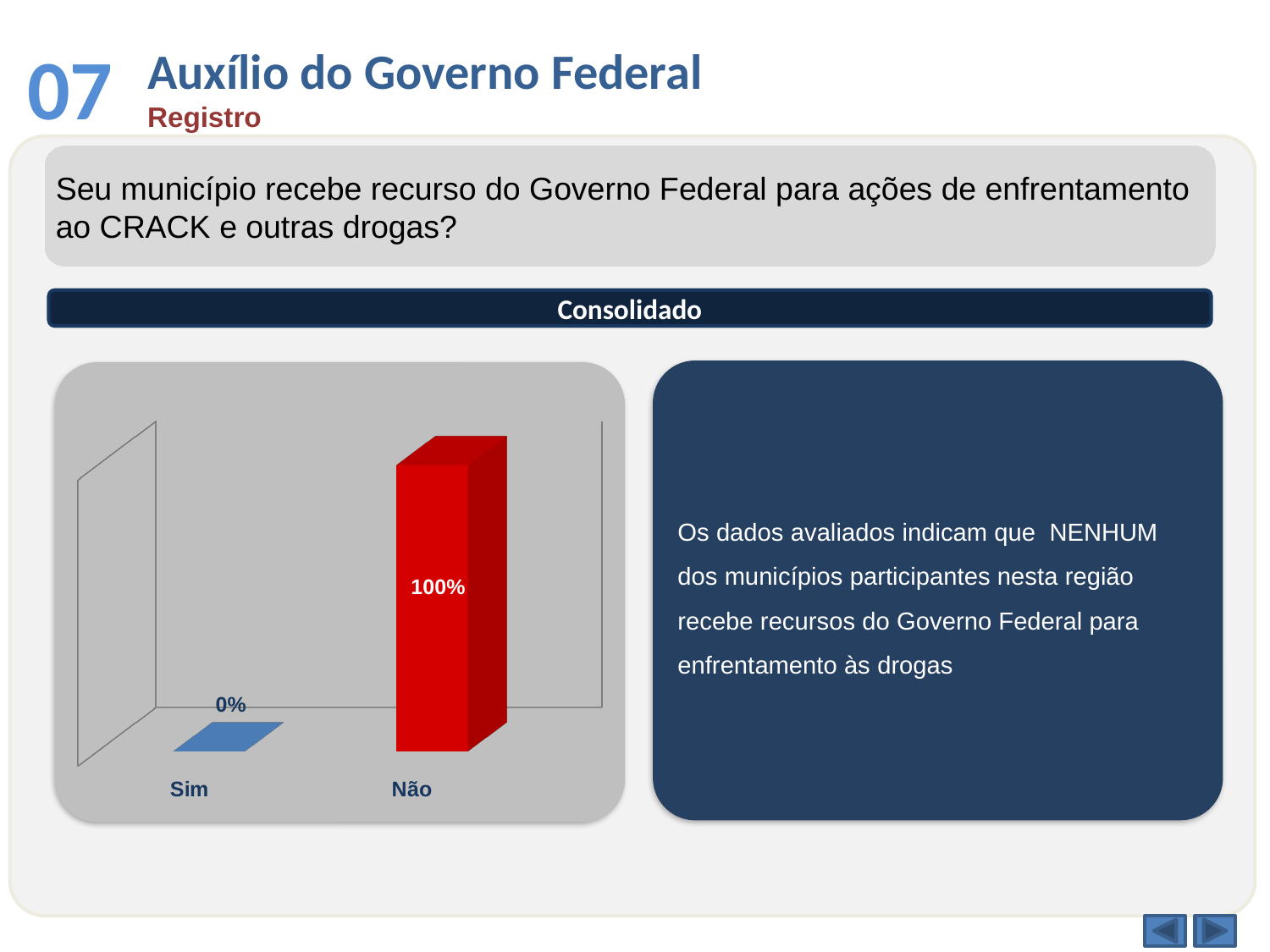
What colour is the bar for Não? Red Which category has the highest value? Não What is the difference between the values for Não and Sim? 100% What is the value for Não? 100% What is the heading shown above the chart? Consolidado What kind of chart is shown on the slide? Bar chart Which category has the lowest value? Sim What is the value for Sim? 0% How many categories are shown in the chart? 2 Which is larger, the value for Sim or the value for Não? Não